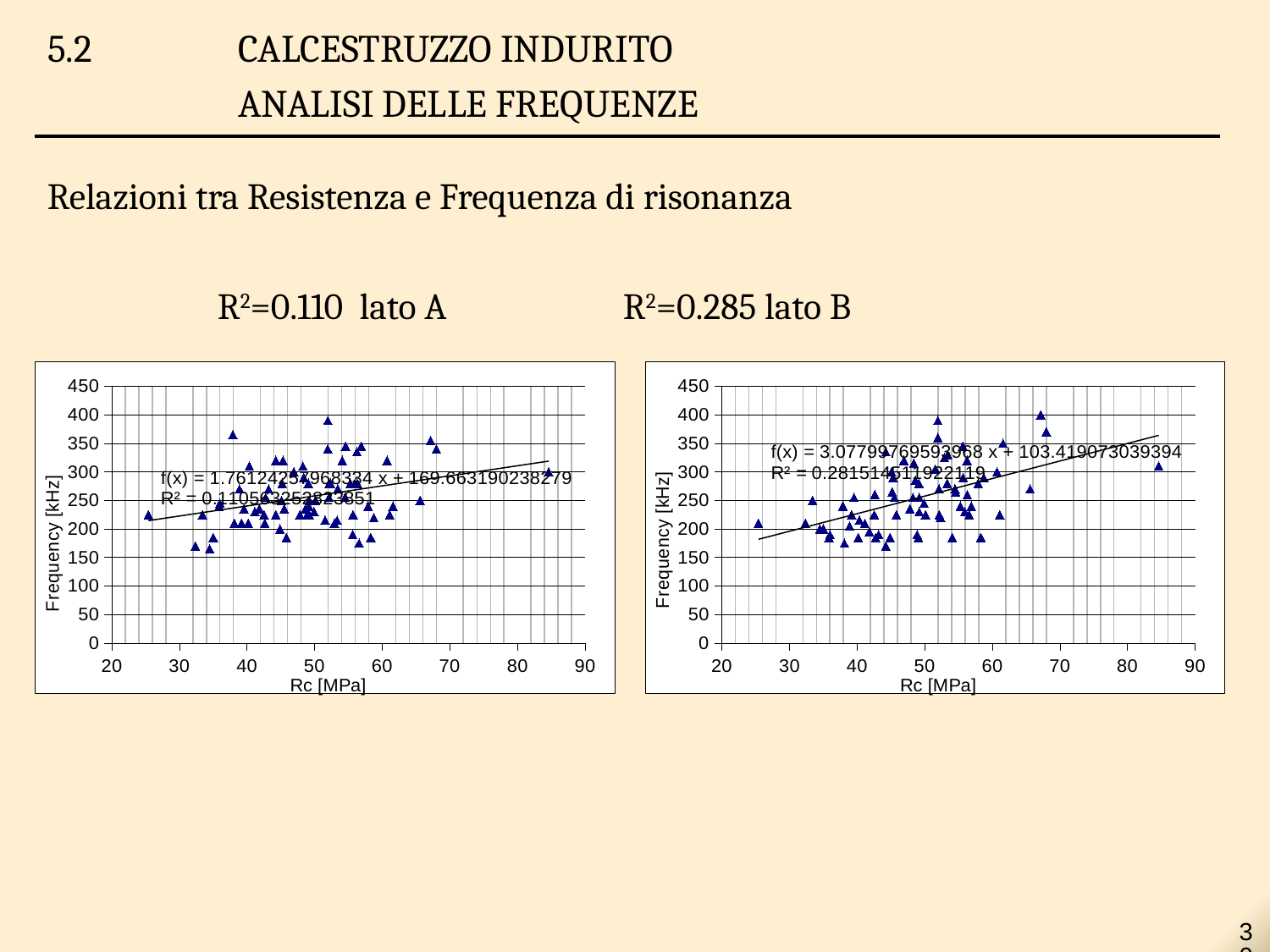
What kind of chart is the left chart (lato A)? Scatter chart In the right chart (lato B), is the highest plotted frequency greater or less than 350? greater In the left chart (lato A), does the fitted trend line rise or fall as Rc increases? Rises What kind of chart is the right chart (lato B)? Scatter chart What is the R² value stated for lato B? 0.285 What is the R² value stated for lato A? 0.110 In the left chart (lato A), is the lowest plotted frequency greater or less than 200? less Which side has the higher R² value, lato A or lato B? lato B What is the label of the x axis on the left chart (lato A)? Rc [MPa] In the right chart (lato B), does the fitted trend line rise or fall as Rc increases? Rises How many charts are shown on the slide? 2 What is the label of the y axis on the right chart (lato B)? Frequency [kHz]